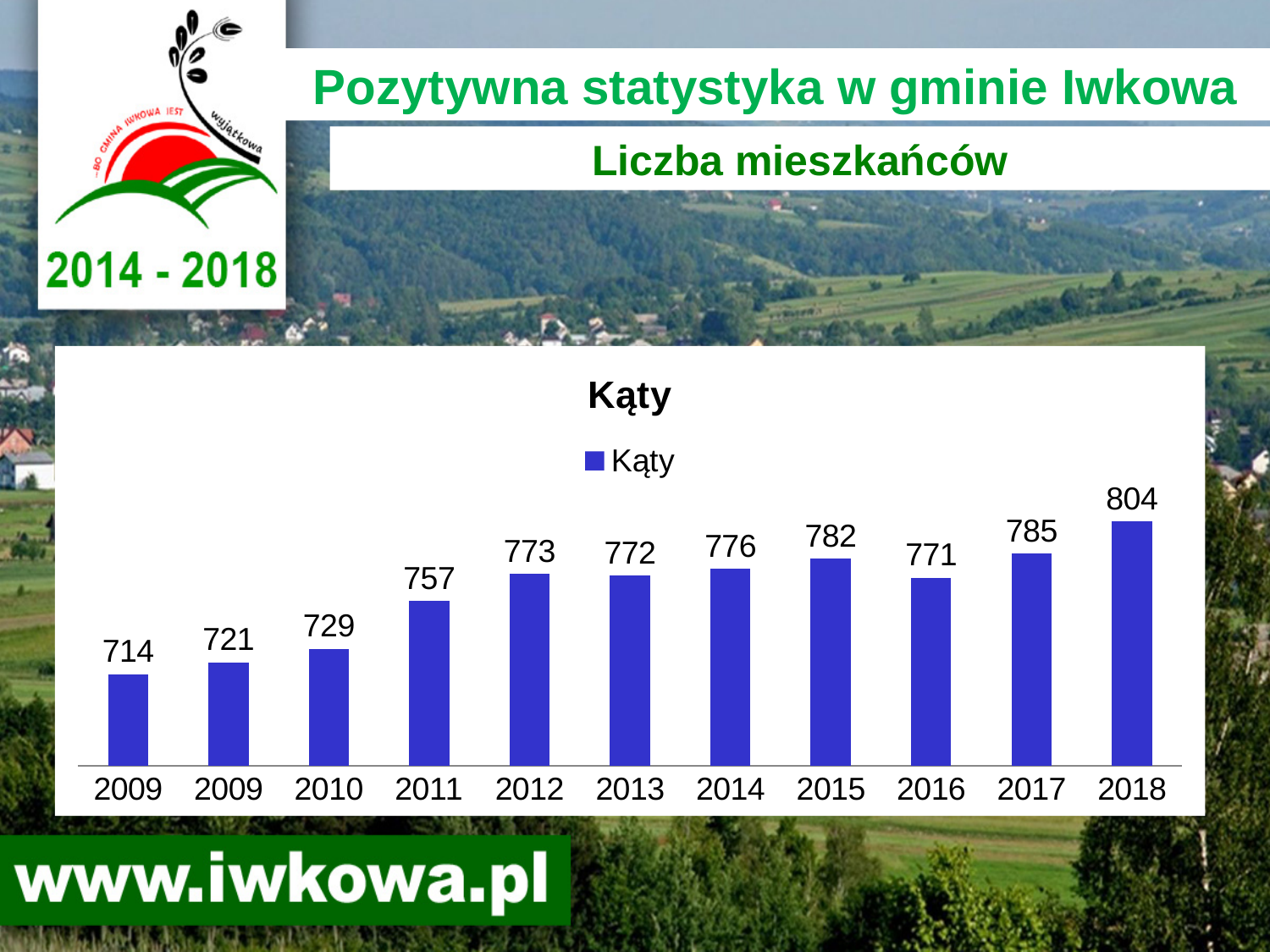
What is the value for 2011? 757 Which year has the highest value? 2018 Which is larger, the value for 2015 or the value for 2016? 2015 What is the value for 2015? 782 What is the difference between the values for 2016 and 2010? 42 How many bars are shown on the chart? 11 Do the values generally rise or fall from left to right along the x axis? rise What is the lowest value shown on the chart? 714 What is the difference between the values for 2018 and 2017? 19 How many series does the legend list? 1 What kind of chart is shown? bar chart What is the value for 2018? 804